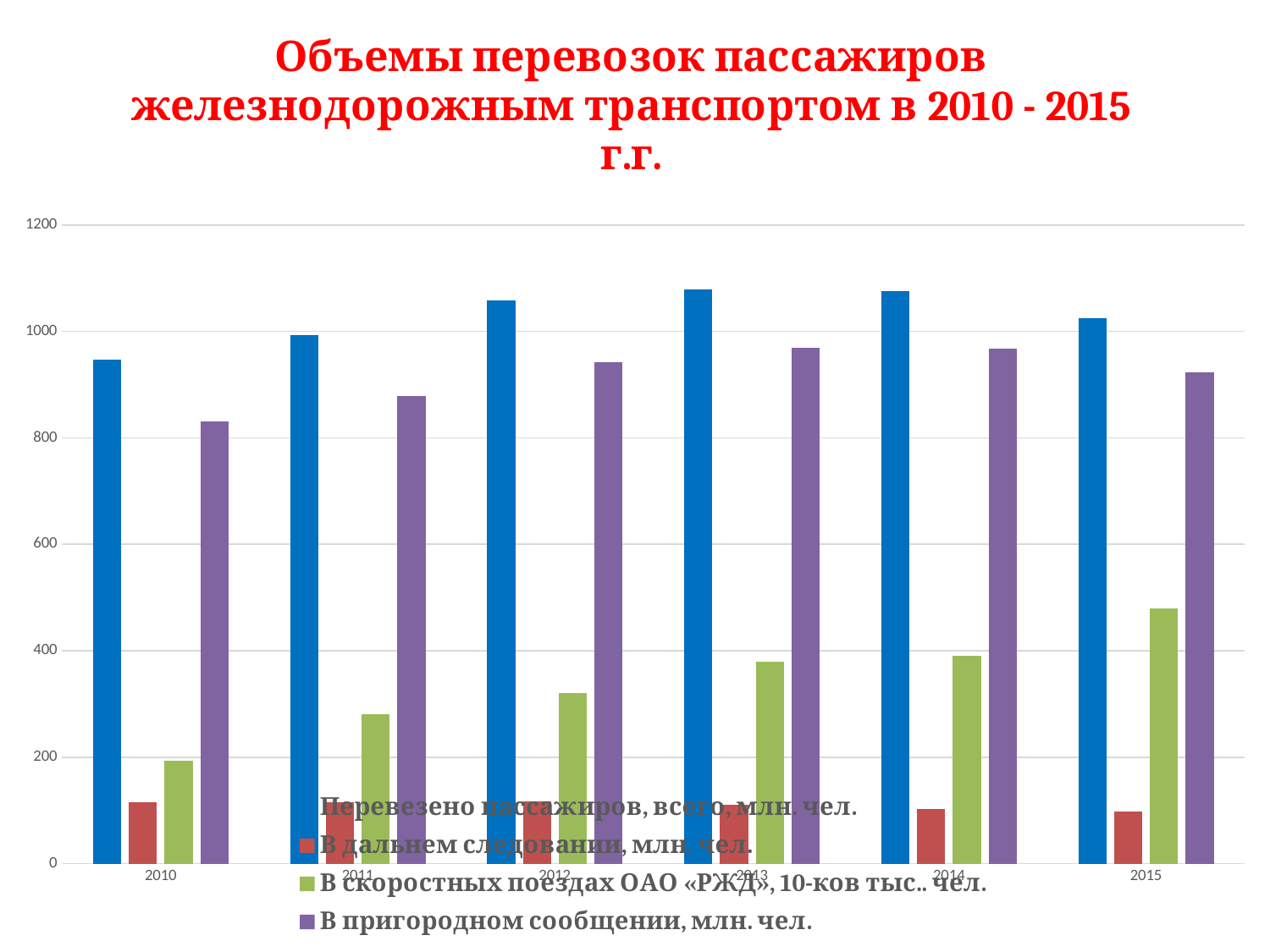
Is the value for 'В скоростных поездах ОАО «РЖД», 10-ков тыс.. чел.' in 2015 greater or less than 400? greater In which year is the value for 'В скоростных поездах ОАО «РЖД», 10-ков тыс.. чел.' the highest? 2015 How many years (categories) are shown on the x axis of the chart? 6 How many series does the legend of the chart list? 4 What colour are the bars for 'В пригородном сообщении, млн. чел.'? purple Is the value for 'Перевезено пассажиров, всего, млн. чел.' in 2013 greater or less than 1000? greater Do the values for 'В скоростных поездах ОАО «РЖД», 10-ков тыс.. чел.' rise or fall from 2010 to 2015? rise Is the value for 'Перевезено пассажиров, всего, млн. чел.' in 2010 greater or less than 1000? less In which year is the value for 'Перевезено пассажиров, всего, млн. чел.' the lowest? 2010 What kind of chart is shown on the slide? bar chart In 2012, which is larger: 'Перевезено пассажиров, всего, млн. чел.' or 'В пригородном сообщении, млн. чел.'? Перевезено пассажиров, всего, млн. чел.